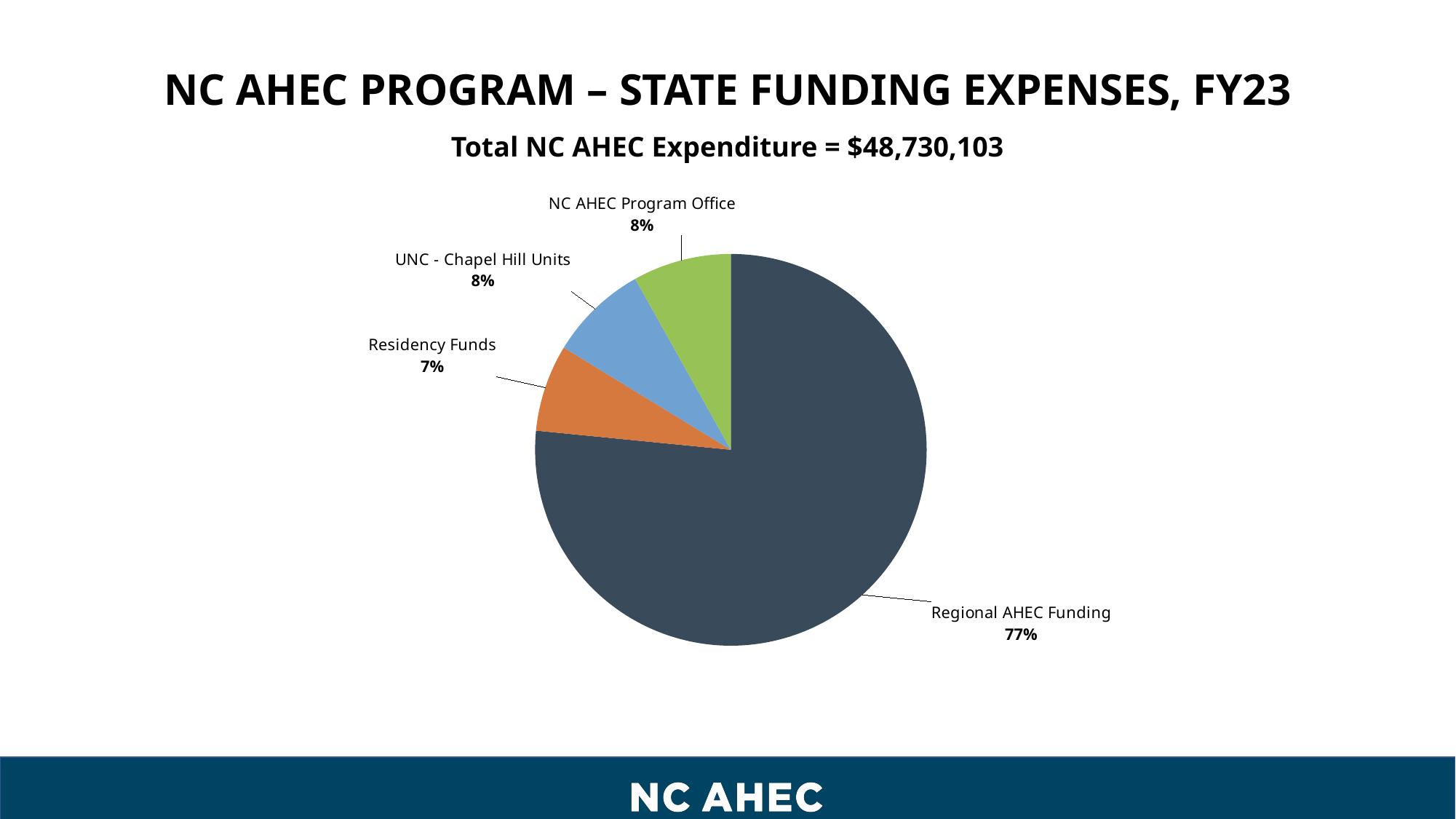
What percentage is shown for NC AHEC Program Office? 8% Which category has the smallest slice of the pie? Residency Funds What kind of chart is shown on the slide? Pie chart Which is larger, the share for Regional AHEC Funding or the share for NC AHEC Program Office? Regional AHEC Funding What share of the pie does Regional AHEC Funding represent? 77% What colour is the Regional AHEC Funding slice? Dark blue-grey Which category has the largest slice of the pie? Regional AHEC Funding What is the total NC AHEC expenditure stated on the slide? $48,730,103 What percentage is shown for UNC - Chapel Hill Units? 8% What percentage is shown for Residency Funds? 7% What is the difference in percentage points between Regional AHEC Funding and Residency Funds? 70 How many categories are shown in the pie chart? 4